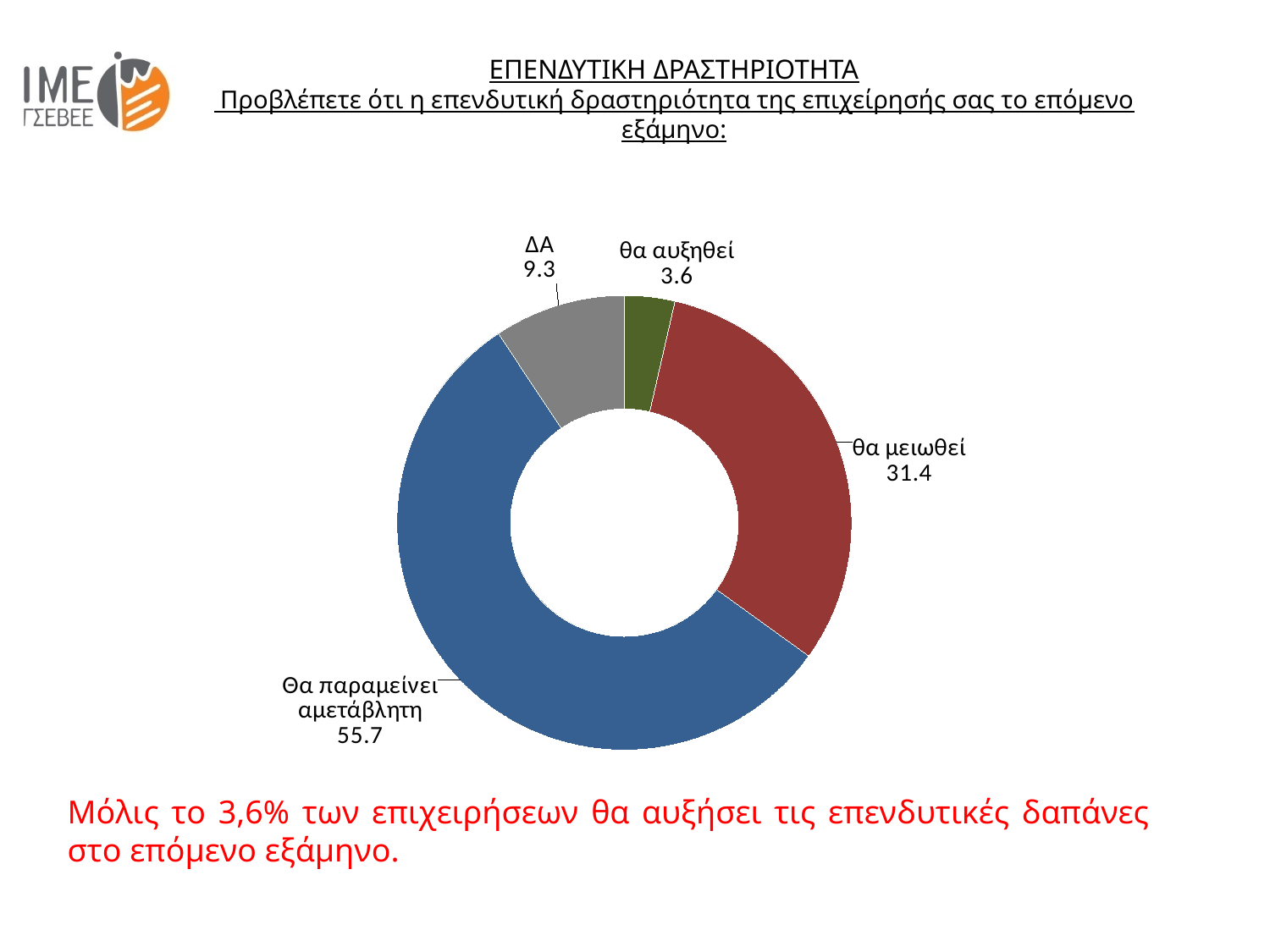
Which is larger, the slice for 'θα μειωθεί' or the slice for 'ΔΑ'? θα μειωθεί What is the difference between the values for 'ΔΑ' and 'θα αυξηθεί'? 5.7 Which category has the smallest slice in the chart? θα αυξηθεί Which category has the largest slice in the chart? Θα παραμείνει αμετάβλητη What value is shown for the slice 'ΔΑ'? 9.3 What kind of chart is shown on the slide? Doughnut chart What colour is the slice for 'θα μειωθεί'? Red How many slices does the chart have? 4 What value is shown for the slice 'Θα παραμείνει αμετάβλητη'? 55.7 What is the difference between the values for 'Θα παραμείνει αμετάβλητη' and 'θα μειωθεί'? 24.3 What value is shown for the slice 'θα μειωθεί'? 31.4 What value is shown for the slice 'θα αυξηθεί'? 3.6